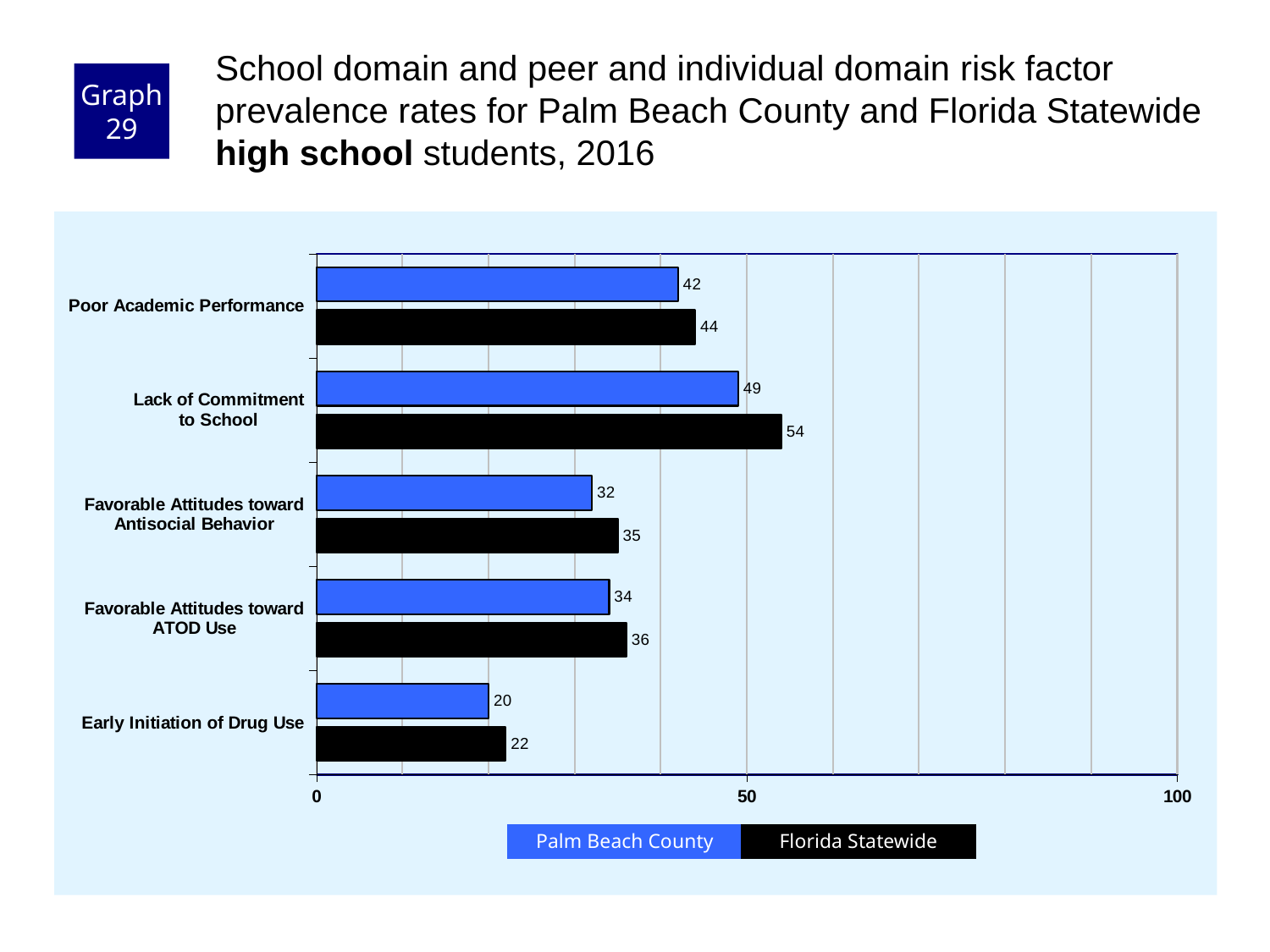
What kind of chart is shown on the slide? bar chart Which risk factor has the highest Florida Statewide value? Lack of Commitment to School Which risk factor has the lowest Palm Beach County value? Early Initiation of Drug Use Is the Florida Statewide value for Lack of Commitment to School greater or less than 50? greater What is the Palm Beach County value for Lack of Commitment to School? 49 What is the difference between the Florida Statewide and Palm Beach County values for Lack of Commitment to School? 5 What is the Florida Statewide value for Favorable Attitudes toward Antisocial Behavior? 35 What is the Florida Statewide value for Early Initiation of Drug Use? 22 How many series does the legend list? 2 What colour are the Florida Statewide bars? black For Poor Academic Performance, which is larger: the Palm Beach County value or the Florida Statewide value? Florida Statewide How many risk factor categories are shown on the chart? 5